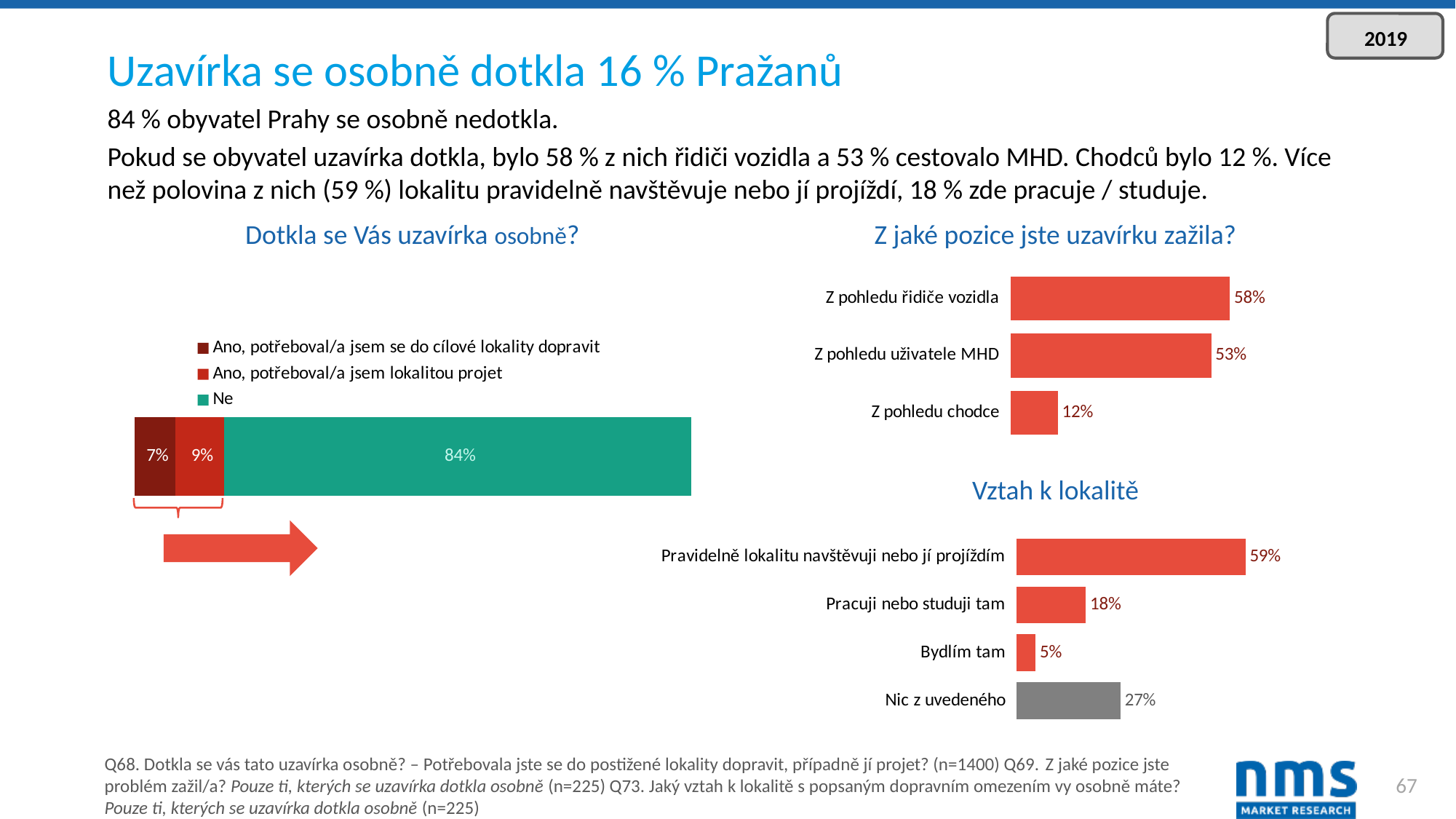
In the chart 'Dotkla se Vás uzavírka osobně?', what is the value for 'Ne'? 84% In the chart 'Vztah k lokalitě', which category has the lowest value? Bydlím tam In the chart 'Dotkla se Vás uzavírka osobně?', what is the value for 'Ano, potřeboval/a jsem lokalitou projet'? 9% In the chart 'Vztah k lokalitě', how many categories are shown? 4 In the chart 'Vztah k lokalitě', what is the value for 'Pracuji nebo studuji tam'? 18% In the chart 'Vztah k lokalitě', which is larger: 'Nic z uvedeného' or 'Pracuji nebo studuji tam'? Nic z uvedeného In the chart 'Z jaké pozice jste uzavírku zažila?', what is the value for 'Z pohledu uživatele MHD'? 53% In the chart 'Dotkla se Vás uzavírka osobně?', how many series does the legend list? 3 What type of chart is 'Vztah k lokalitě'? Bar chart In the chart 'Dotkla se Vás uzavírka osobně?', what is the combined value of the two 'Ano' segments? 16% In the chart 'Z jaké pozice jste uzavírku zažila?', which category has the highest value? Z pohledu řidiče vozidla In the chart 'Z jaké pozice jste uzavírku zažila?', what is the difference between 'Z pohledu řidiče vozidla' and 'Z pohledu chodce'? 46%